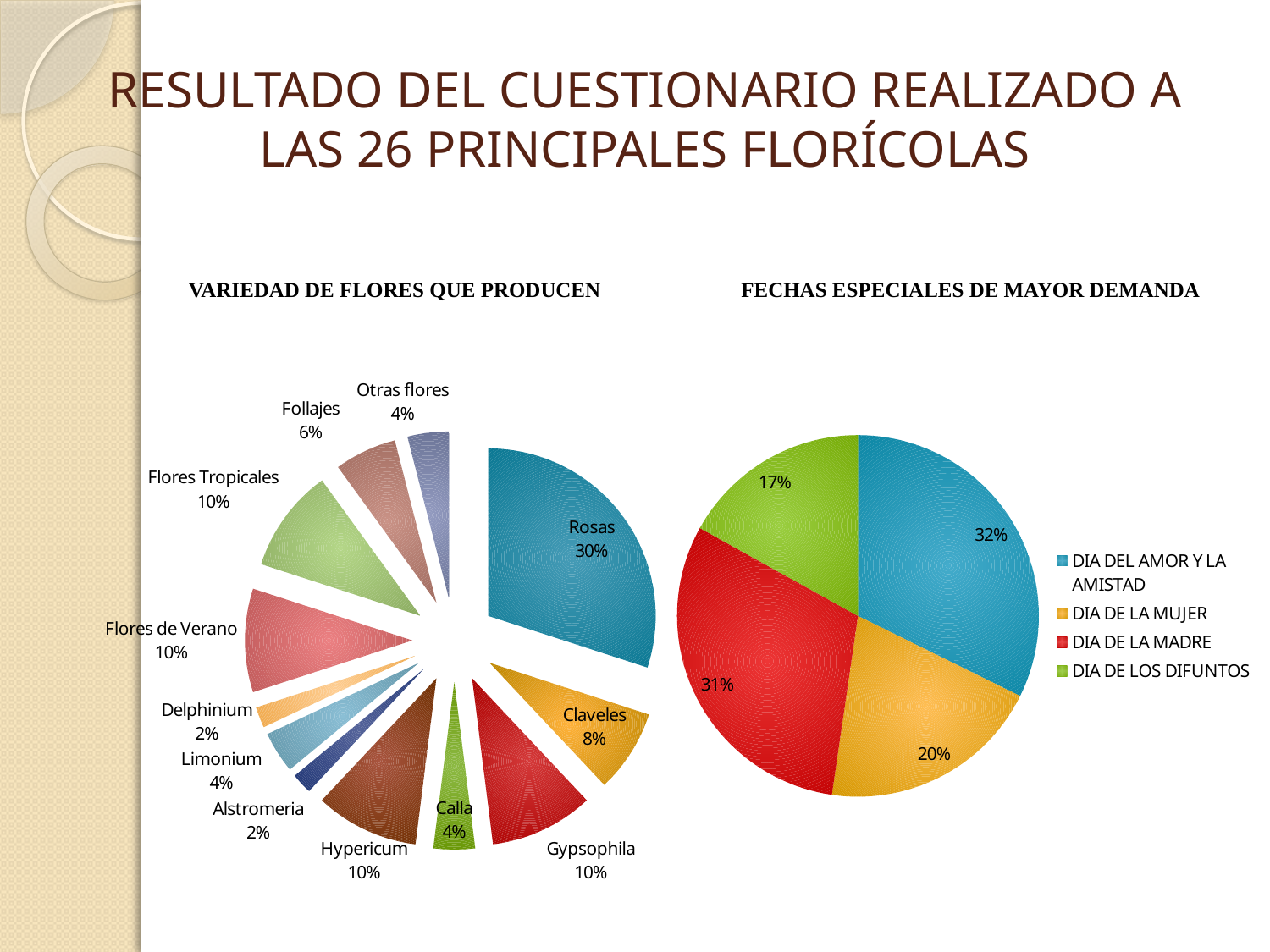
In the 'VARIEDAD DE FLORES QUE PRODUCEN' chart, what share does Claveles have? 8% In the 'FECHAS ESPECIALES DE MAYOR DEMANDA' chart, how many entries does the legend list? 4 In the 'FECHAS ESPECIALES DE MAYOR DEMANDA' chart, what is the difference between the shares of DIA DEL AMOR Y LA AMISTAD and DIA DE LOS DIFUNTOS? 15% What kind of chart is the 'FECHAS ESPECIALES DE MAYOR DEMANDA' chart? Pie chart In the 'VARIEDAD DE FLORES QUE PRODUCEN' chart, what share does Rosas have? 30% In the 'FECHAS ESPECIALES DE MAYOR DEMANDA' chart, what share does DIA DE LA MUJER have? 20% In the 'VARIEDAD DE FLORES QUE PRODUCEN' chart, what is the difference between the shares of Rosas and Follajes? 24% In the 'VARIEDAD DE FLORES QUE PRODUCEN' chart, which is larger, the share of Hypericum or the share of Calla? Hypericum In the 'VARIEDAD DE FLORES QUE PRODUCEN' chart, which flower variety has the largest share? Rosas In the 'FECHAS ESPECIALES DE MAYOR DEMANDA' chart, what colour is the DIA DE LA MADRE slice? Red In the 'VARIEDAD DE FLORES QUE PRODUCEN' chart, how many slices does the pie have? 12 In the 'FECHAS ESPECIALES DE MAYOR DEMANDA' chart, which date has the smallest share? DIA DE LOS DIFUNTOS